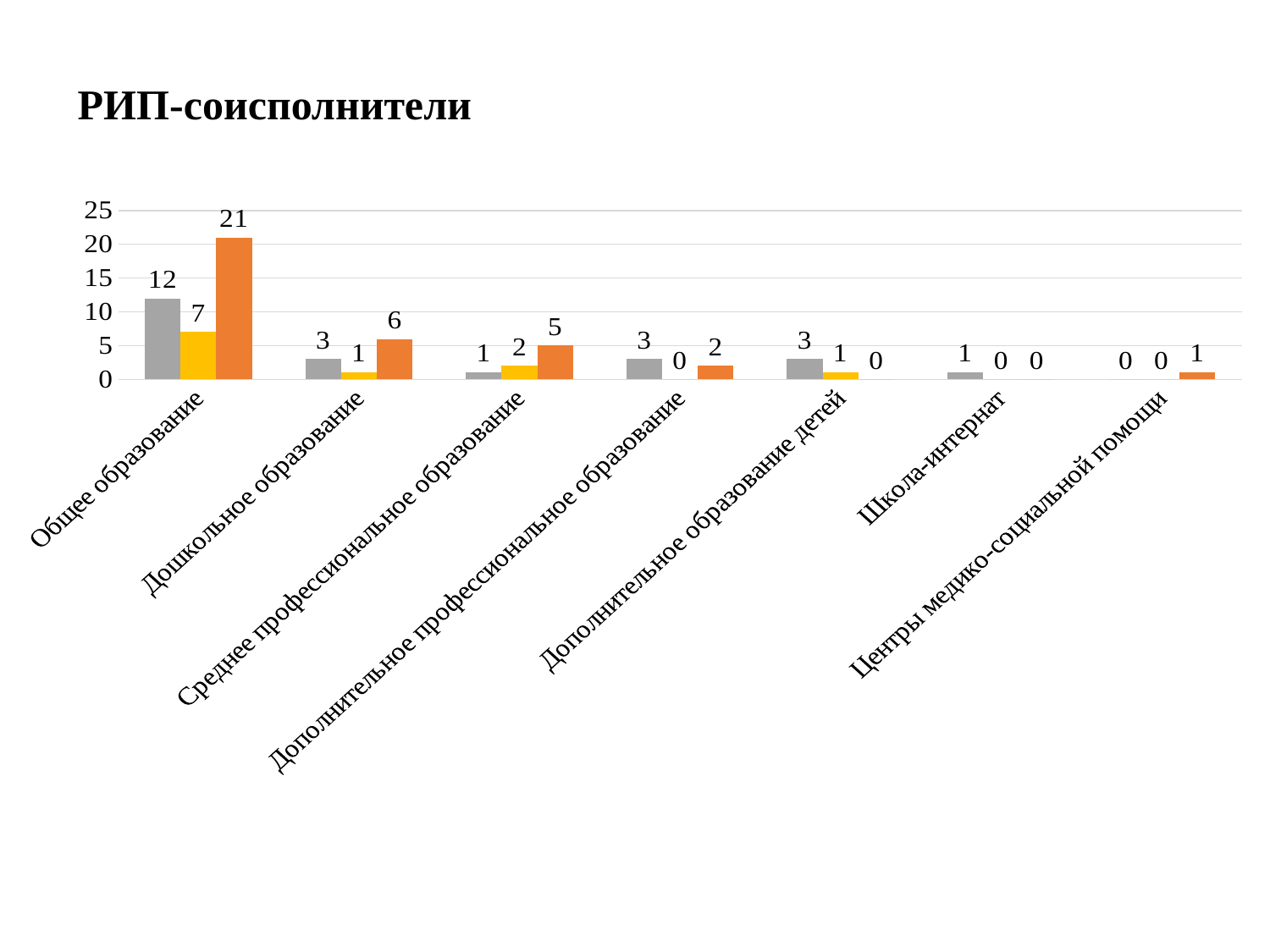
What is the value of the yellow bar for Среднее профессиональное образование? 2 What is the value of the orange bar for Центры медико-социальной помощи? 1 Which category has the highest orange bar? Общее образование Which is larger for Дополнительное профессиональное образование: the grey bar or the orange bar? the grey bar What is the difference between the orange and grey bars for Общее образование? 9 What is the value of the grey bar for Общее образование? 12 What is the title of the chart? РИП-соисполнители What is the difference between the orange bars for Дошкольное образование and Среднее профессиональное образование? 1 What is the value of the orange bar for Дошкольное образование? 6 How many categories are shown on the x axis? 7 What is the value of the orange bar for Общее образование? 21 What kind of chart is shown on the slide? bar chart